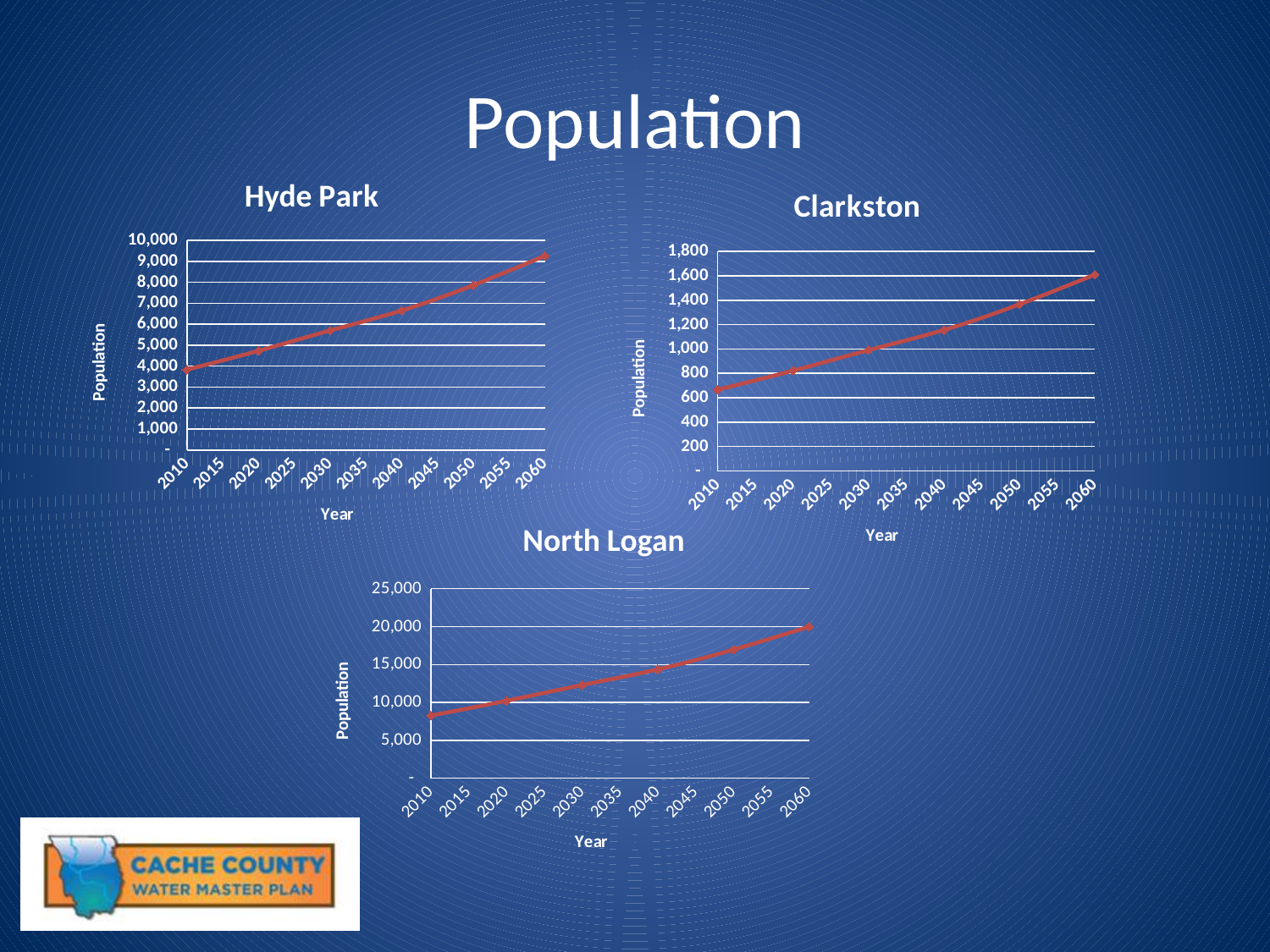
In the Clarkston chart, is the population value for 2040 greater or less than 1,000? greater In the Clarkston chart, which year has the lowest population? 2010 In the Clarkston chart, is the population value for 2010 greater or less than 600? greater In the Hyde Park chart, which year has the highest population? 2060 How many data points are plotted on the Clarkston chart? 6 What is the label on the x axis of the North Logan chart? Year What kind of chart is the Hyde Park chart? line chart In the Hyde Park chart, is the population value for 2040 greater or less than 6,000? greater In the Hyde Park chart, does the population rise or fall from 2010 to 2060? rise